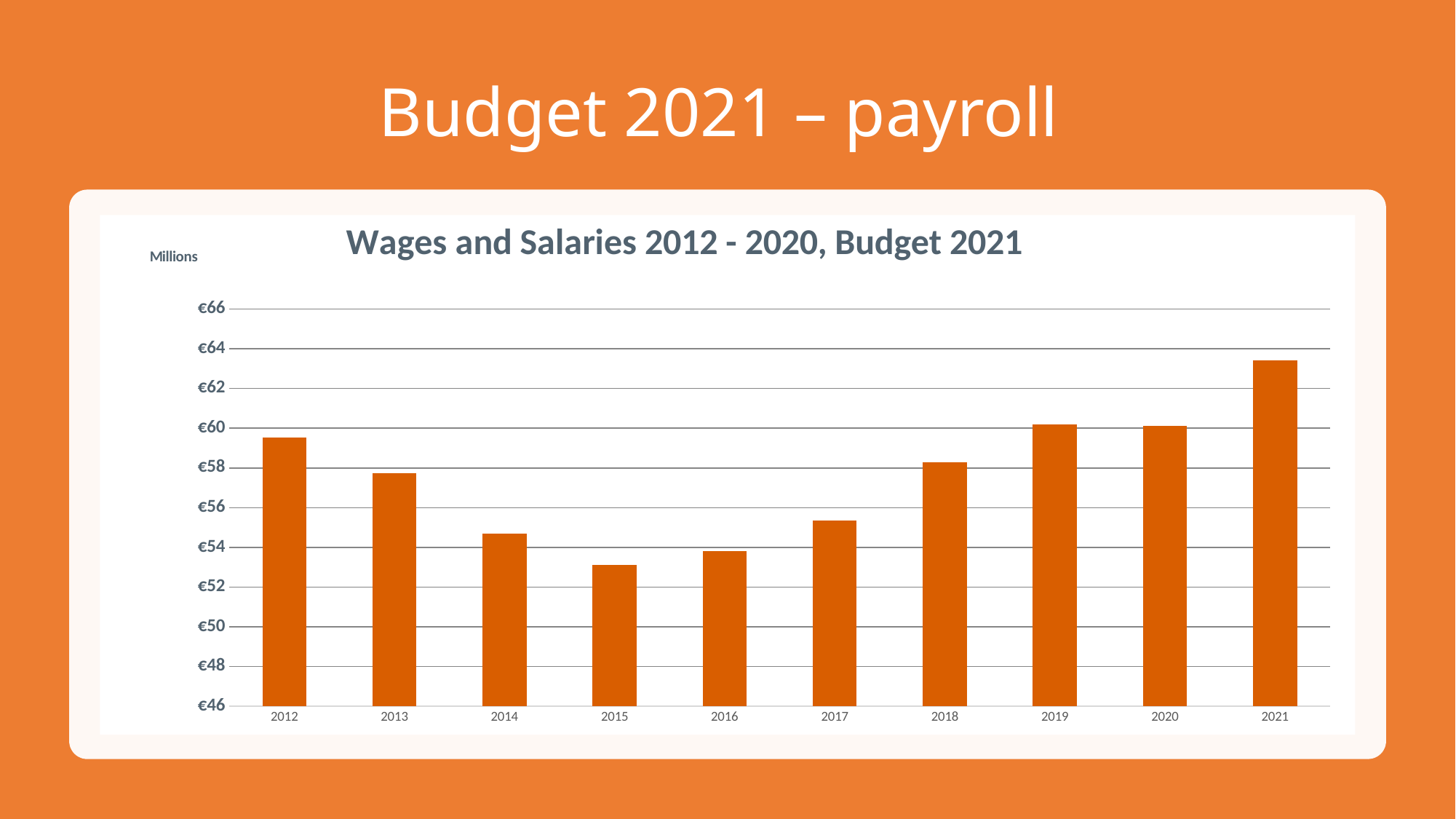
Which is larger, the value for 2014 or the value for 2016? 2014 Which is larger, the value for 2012 or the value for 2013? 2012 Which year has the lowest value in the chart? 2015 Do the values rise or fall from 2015 to 2021? rise How many years are plotted on the x axis of the chart? 10 What is the title of the chart? Wages and Salaries 2012 - 2020, Budget 2021 Is the value for 2015 greater or less than €54? less Is the value for 2017 greater or less than €54? greater Is the value for 2021 greater or less than €62? greater Which year has the highest value in the chart? 2021 What kind of chart is shown on the slide? bar chart